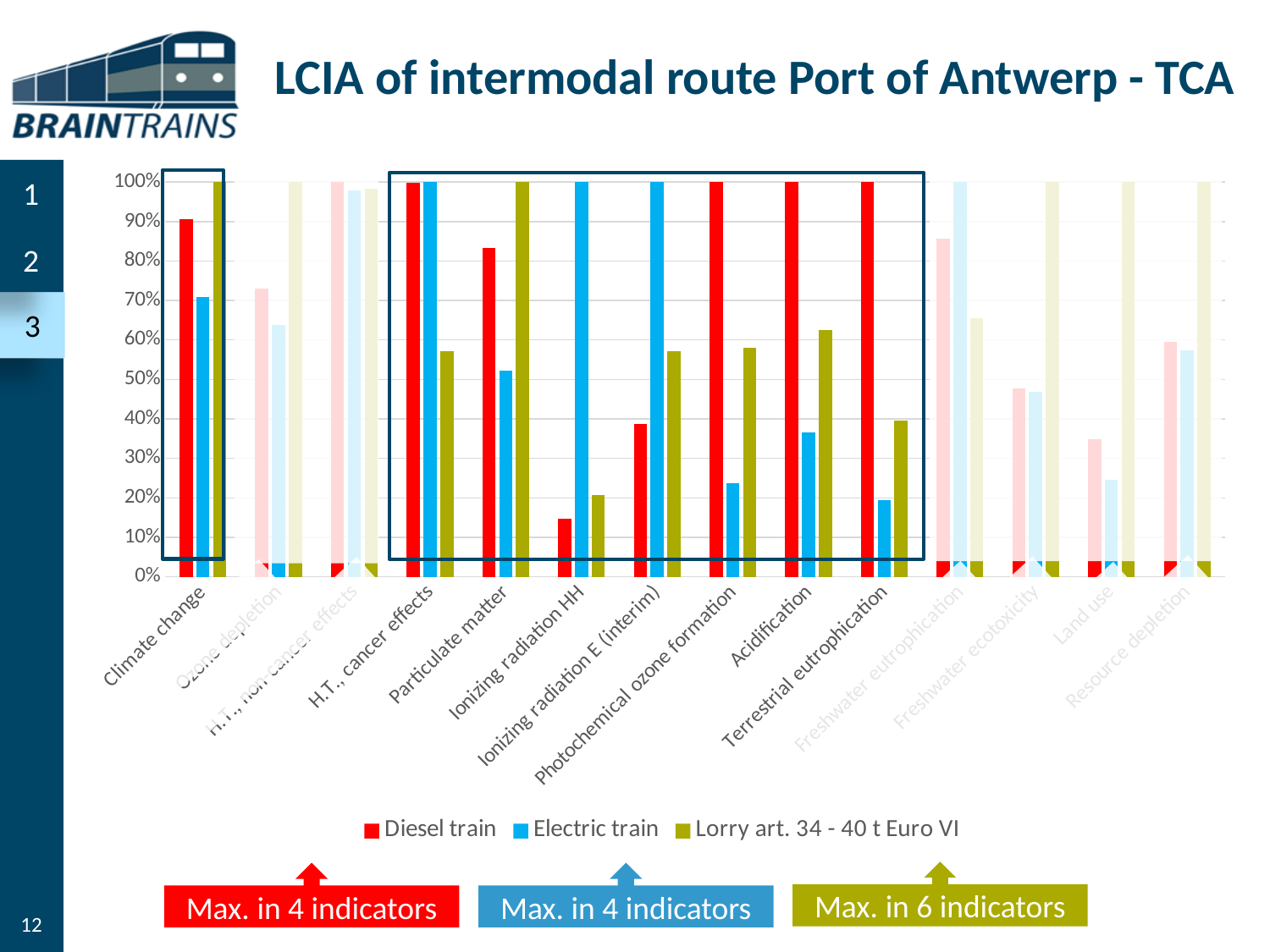
How many categories are plotted along the x axis? 14 Which series has the highest value in the Terrestrial eutrophication category? Diesel train In the Photochemical ozone formation category, which is larger: the Electric train value or the Lorry art. 34 - 40 t Euro VI value? Lorry art. 34 - 40 t Euro VI What is the value for Electric train in the Ionizing radiation HH category? 100% How many series does the legend list? 3 Which series has the lowest value in the Ionizing radiation HH category? Diesel train What kind of chart is shown on the slide? bar chart Is the value for Diesel train in the Climate change category greater or less than 80%? greater What is the value for Lorry art. 34 - 40 t Euro VI in the Climate change category? 100% What is the value for Diesel train in the Acidification category? 100% What is the title of the slide containing the chart? LCIA of intermodal route Port of Antwerp - TCA Is the value for Electric train in the Particulate matter category greater or less than 60%? less